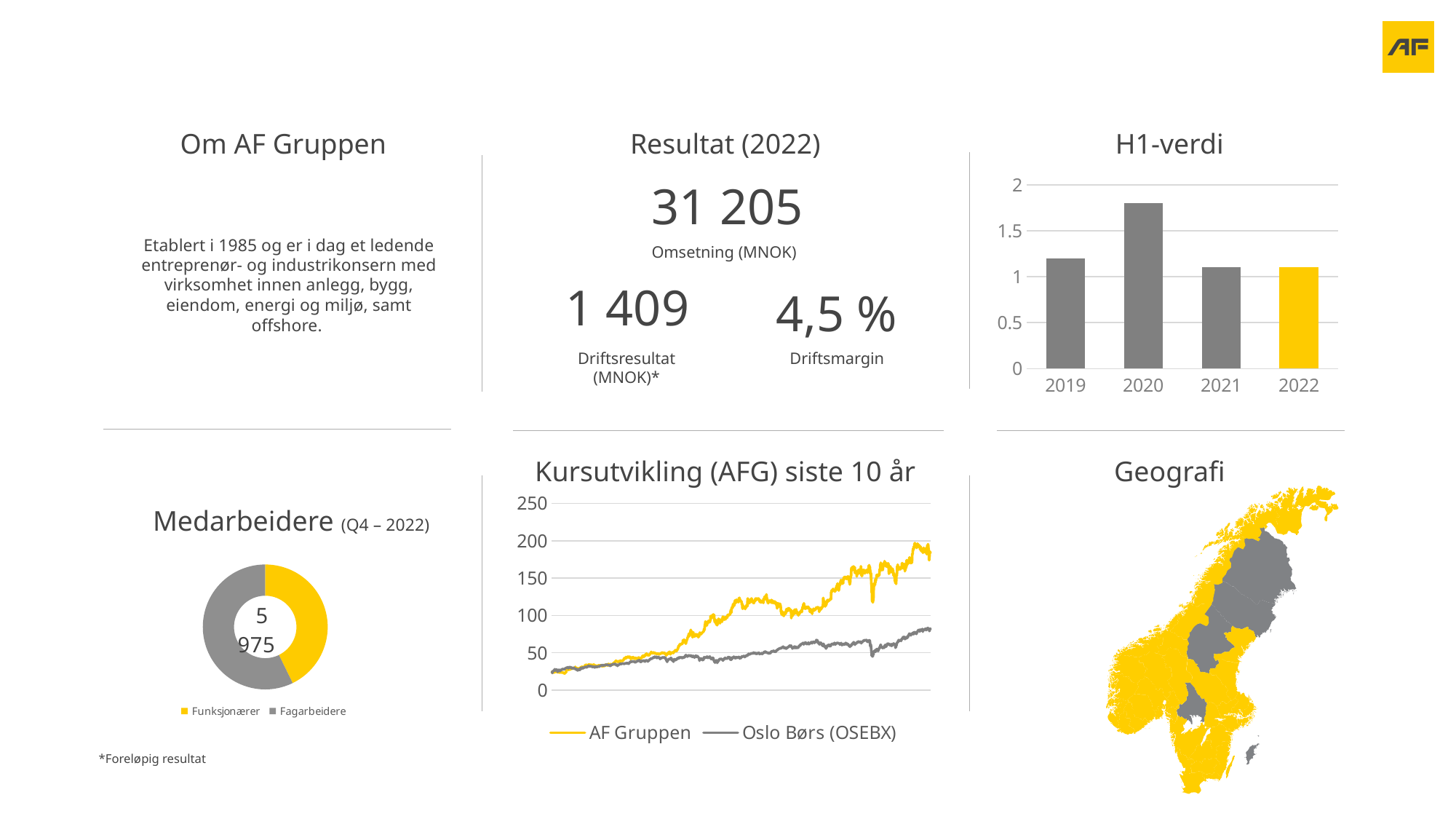
What number is shown in the centre of the Medarbeidere chart? 5 975 In the Medarbeidere chart, which group has the larger share: Funksjonærer or Fagarbeidere? Fagarbeidere In the H1-verdi chart, is the value for 2020 greater or less than 1.5? greater In the H1-verdi chart, is the value for 2019 greater or less than 1? greater How many series does the legend of the Kursutvikling (AFG) siste 10 år chart list? 2 What kind of chart is the H1-verdi chart? Bar chart In the Kursutvikling (AFG) siste 10 år chart, does the AF Gruppen line generally rise or fall over time? Rise How many years are shown in the H1-verdi chart? 4 In the H1-verdi chart, which year has the highest bar? 2020 In the H1-verdi chart, is the value for 2021 greater or less than 1.5? less How many categories does the legend of the Medarbeidere chart list? 2 In the H1-verdi chart, which bar is coloured yellow? 2022